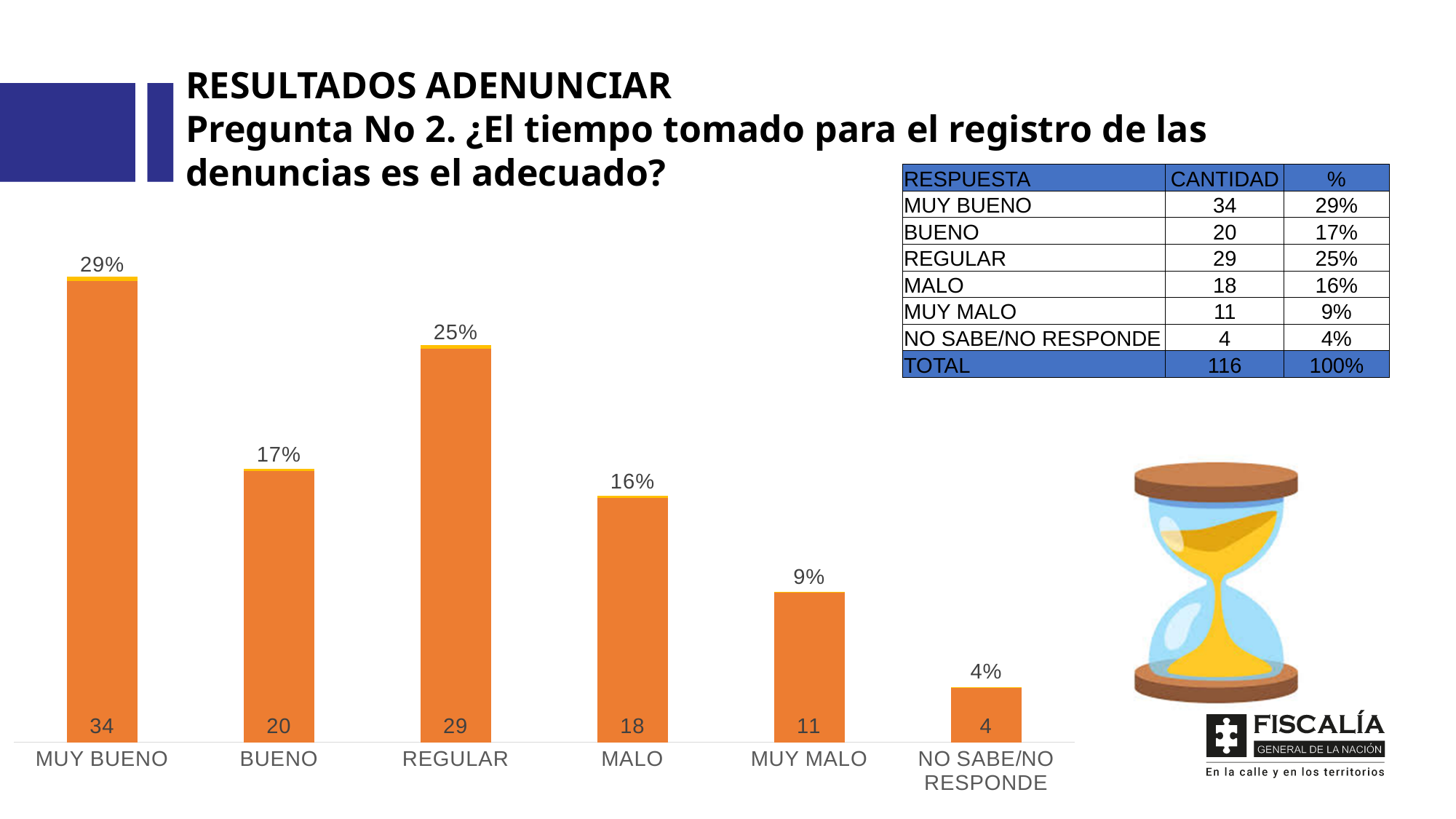
What count is shown inside the bar for NO SABE/NO RESPONDE? 4 What is the difference in count between REGULAR and MALO? 11 Which is larger, the bar for BUENO or the bar for MALO? BUENO What kind of chart is shown? Bar chart What percentage is shown for MUY BUENO? 29% What is the difference in percentage points between MUY BUENO and BUENO? 12 How many categories are shown on the x axis? 6 Which category has the highest bar? MUY BUENO Which category has the lowest bar? NO SABE/NO RESPONDE What count is shown inside the bar for REGULAR? 29 What colour are the bars in the chart? Orange What percentage is shown for MUY MALO? 9%